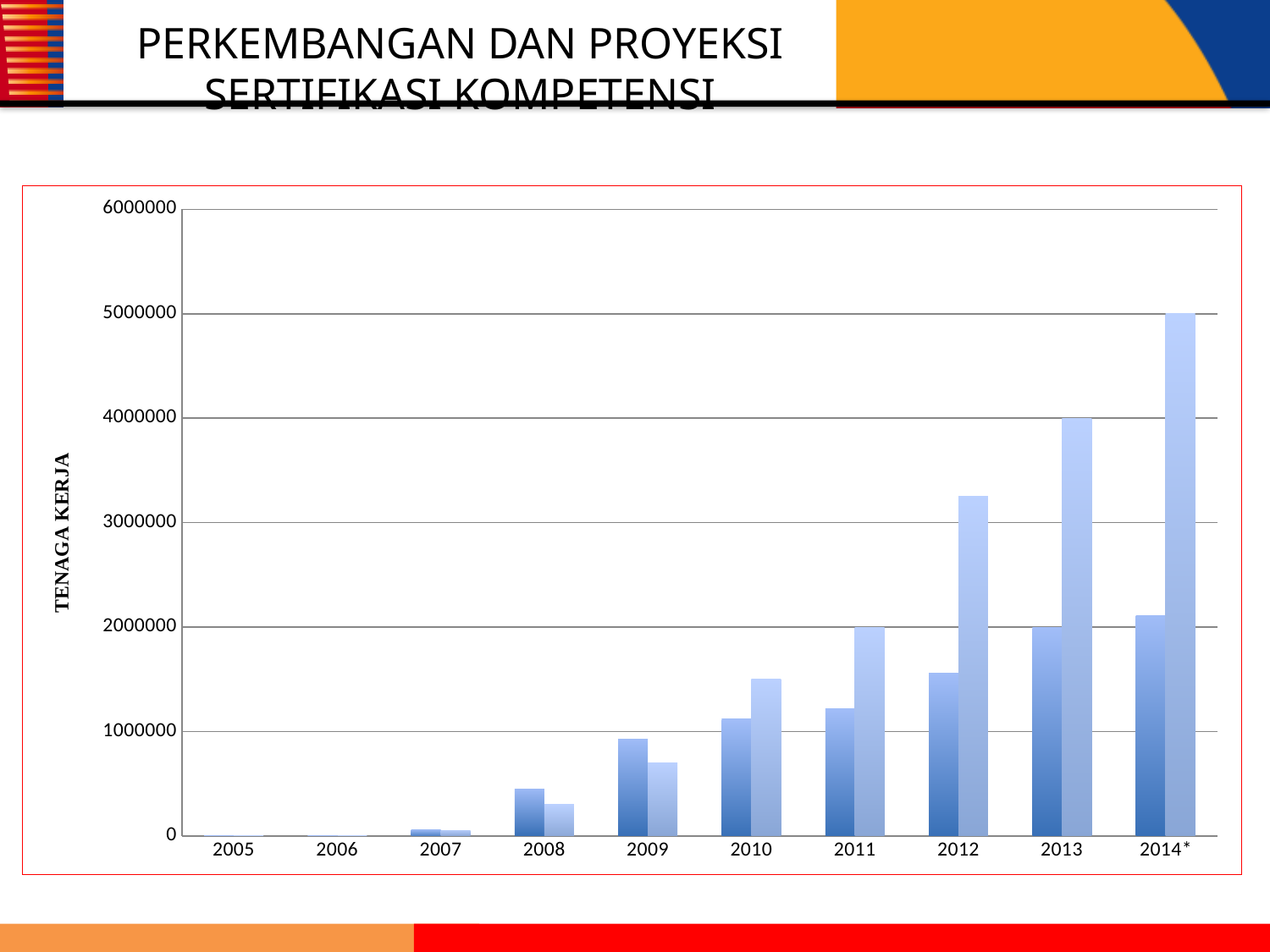
What is the value of the lighter blue bar for 2013? 4000000 How many years are shown on the x axis of the chart? 10 Do the lighter blue bars generally rise or fall from 2007 to 2014*? rise What is the value of the lighter blue bar for 2011? 2000000 Is the lighter blue bar for 2012 greater or less than 3000000? greater Which year has the tallest lighter blue bar? 2014* Is the darker blue bar for 2009 greater or less than 1000000? less What kind of chart is shown on the slide? bar chart For 2009, which is larger, the darker blue bar or the lighter blue bar? the darker blue bar What is the label of the y axis? TENAGA KERJA What is the value of the lighter blue bar for 2014*? 5000000